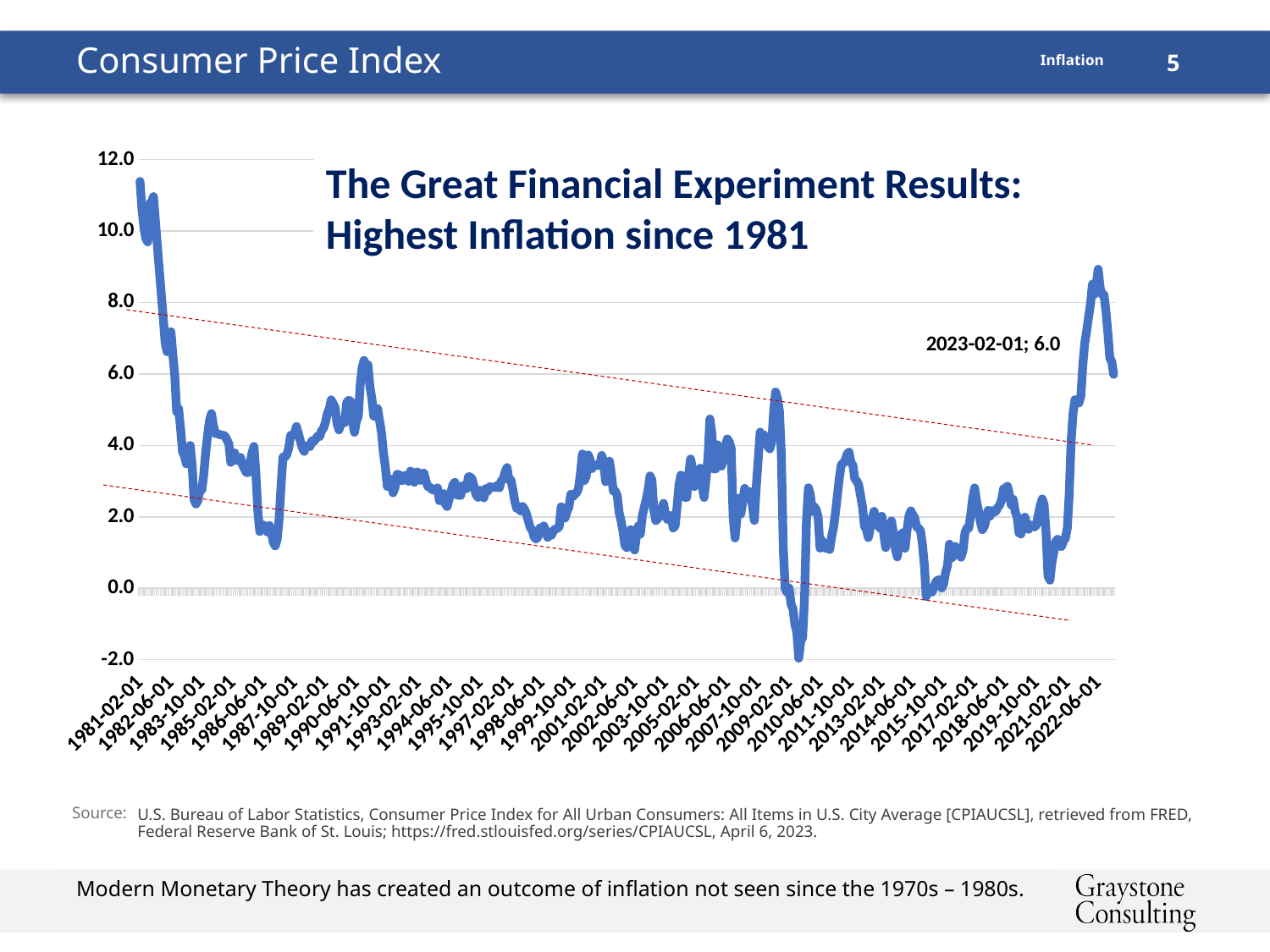
What kind of chart is shown on the slide? line chart Does the line rise or fall between 1981-02-01 and 1983-10-01? fall Is the value at 2022-06-01 greater or less than 4.0? greater Is the lowest point of the line, around 2009, greater or less than 0.0? less What is the highest value shown on the vertical axis? 12.0 Is the value at 1990-06-01 greater or less than 4.0? greater What value is labeled on the chart for 2023-02-01? 6.0 Does the line rise or fall between 2021-02-01 and 2022-06-01? rise What is the title printed on the chart? The Great Financial Experiment Results: Highest Inflation since 1981 How many red dashed trend lines are drawn on the chart? 2